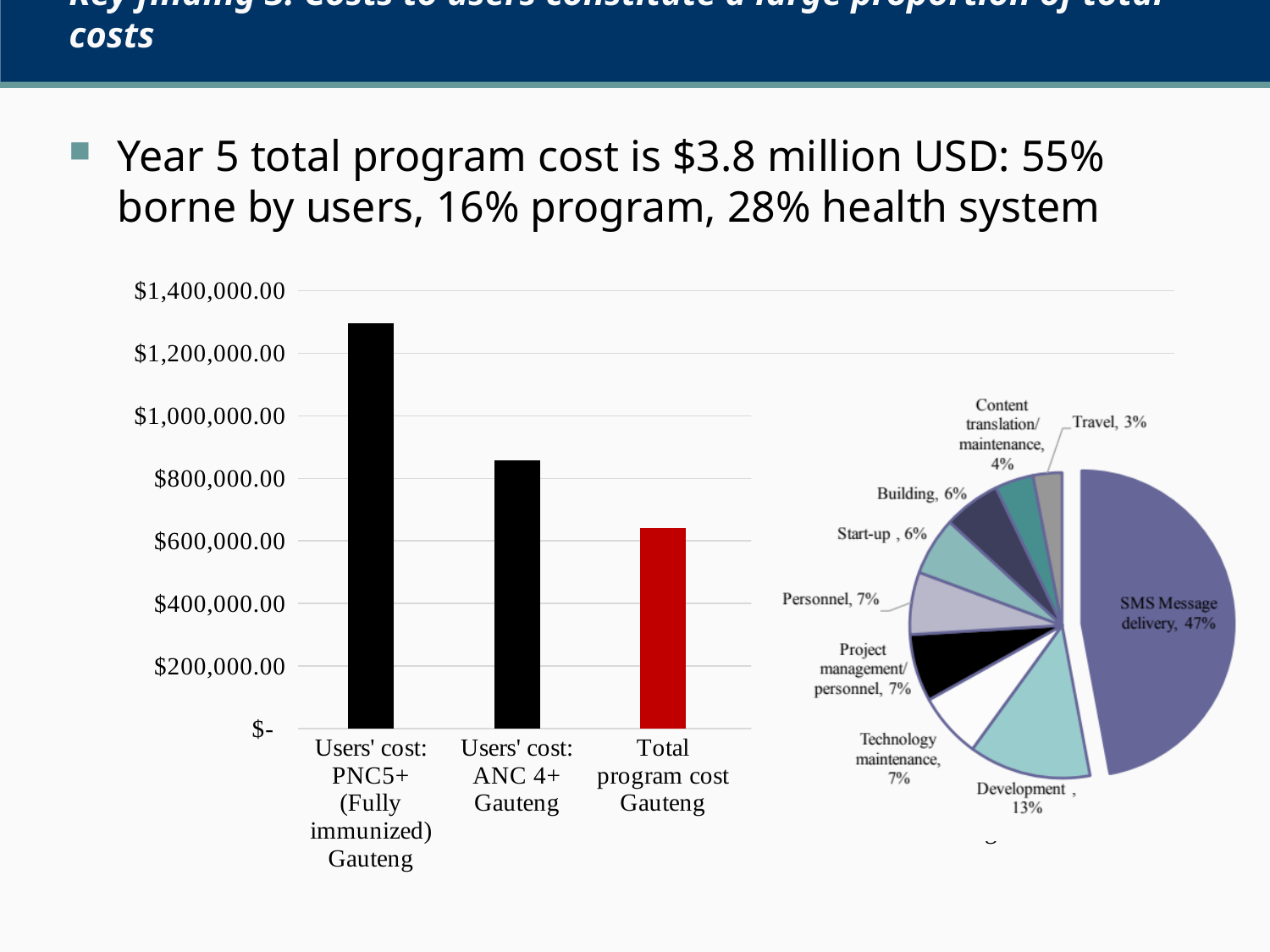
In the bar chart on the left, is the value for Total program cost Gauteng greater or less than $600,000.00? greater In the pie chart on the right, what share does SMS Message delivery have? 47% In the pie chart on the right, what share does Development have? 13% In the bar chart on the left, which category has the highest value? Users' cost: PNC5+ (Fully immunized) Gauteng What kind of chart is the chart on the left of the slide? bar chart What kind of chart is the chart on the right of the slide? pie chart In the bar chart on the left, how many bars are plotted? 3 In the bar chart on the left, which category has the lowest value? Total program cost Gauteng In the bar chart on the left, is the value for Users' cost: ANC 4+ Gauteng greater or less than $1,000,000.00? less In the bar chart on the left, which is larger: Users' cost: ANC 4+ Gauteng or Total program cost Gauteng? Users' cost: ANC 4+ Gauteng In the pie chart on the right, which slice is the smallest? Travel In the bar chart on the left, is the value for Users' cost: PNC5+ (Fully immunized) Gauteng greater or less than $1,200,000.00? greater